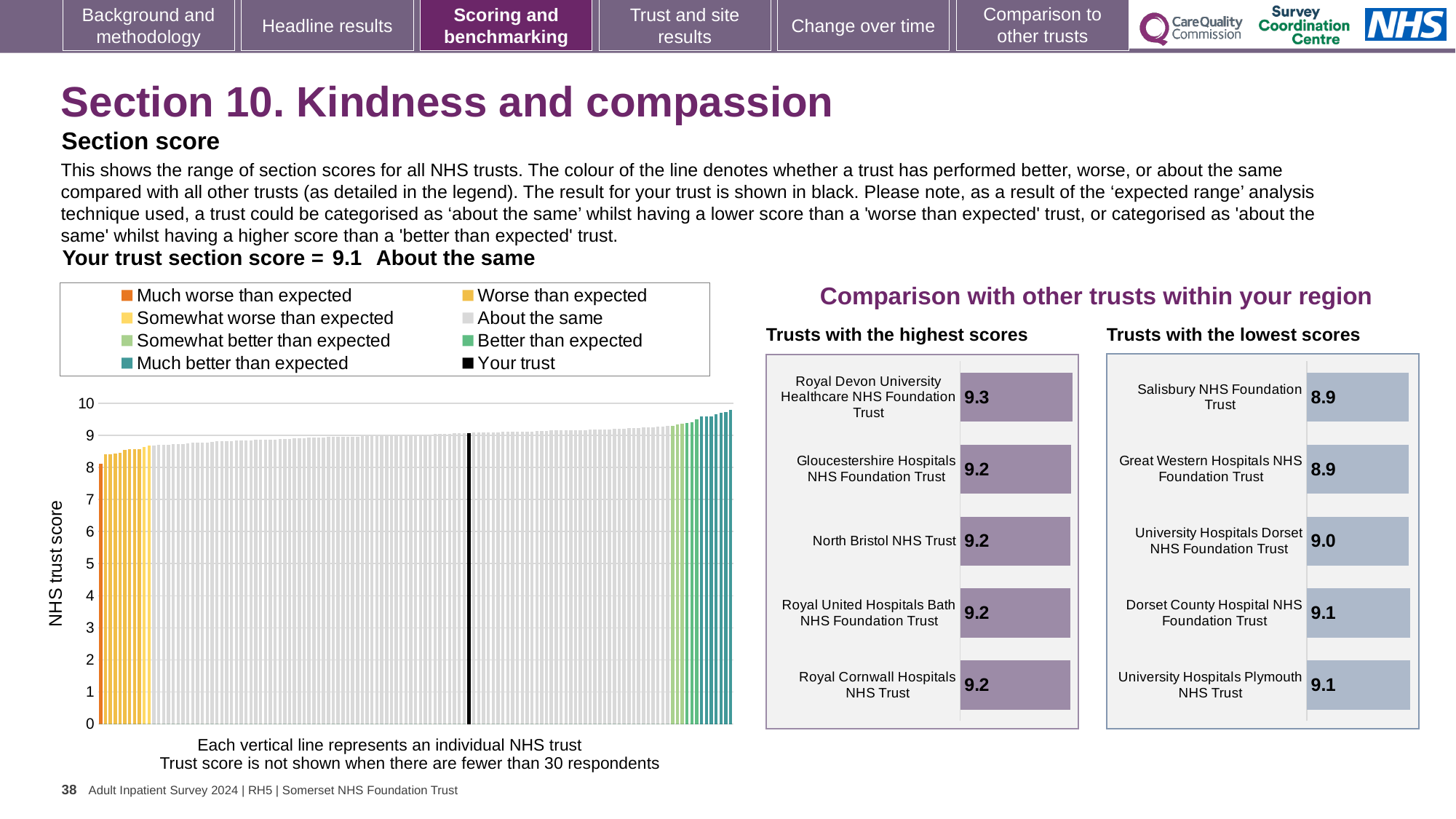
In the 'Trusts with the highest scores' chart, which has the larger score: Royal Devon University Healthcare NHS Foundation Trust or Gloucestershire Hospitals NHS Foundation Trust? Royal Devon University Healthcare NHS Foundation Trust In the 'Trusts with the highest scores' chart, what is the score for Royal Devon University Healthcare NHS Foundation Trust? 9.3 How many entries does the legend of the main NHS trust score chart list? 8 What kind of chart is the 'Trusts with the highest scores' chart? Bar chart In the 'Trusts with the lowest scores' chart, what is the score for University Hospitals Dorset NHS Foundation Trust? 9.0 In the 'Trusts with the lowest scores' chart, what is the difference between the scores of Dorset County Hospital NHS Foundation Trust and Salisbury NHS Foundation Trust? 0.2 In the main NHS trust score chart, is the value of the leftmost (lowest) bar greater or less than 9? less What is the y-axis label of the main NHS trust score chart? NHS trust score In the 'Trusts with the highest scores' chart, which trust has the highest score? Royal Devon University Healthcare NHS Foundation Trust In the 'Trusts with the lowest scores' chart, what is the score for Salisbury NHS Foundation Trust? 8.9 How many trusts are listed in the 'Trusts with the lowest scores' chart? 5 In the 'Trusts with the highest scores' chart, what is the score for North Bristol NHS Trust? 9.2